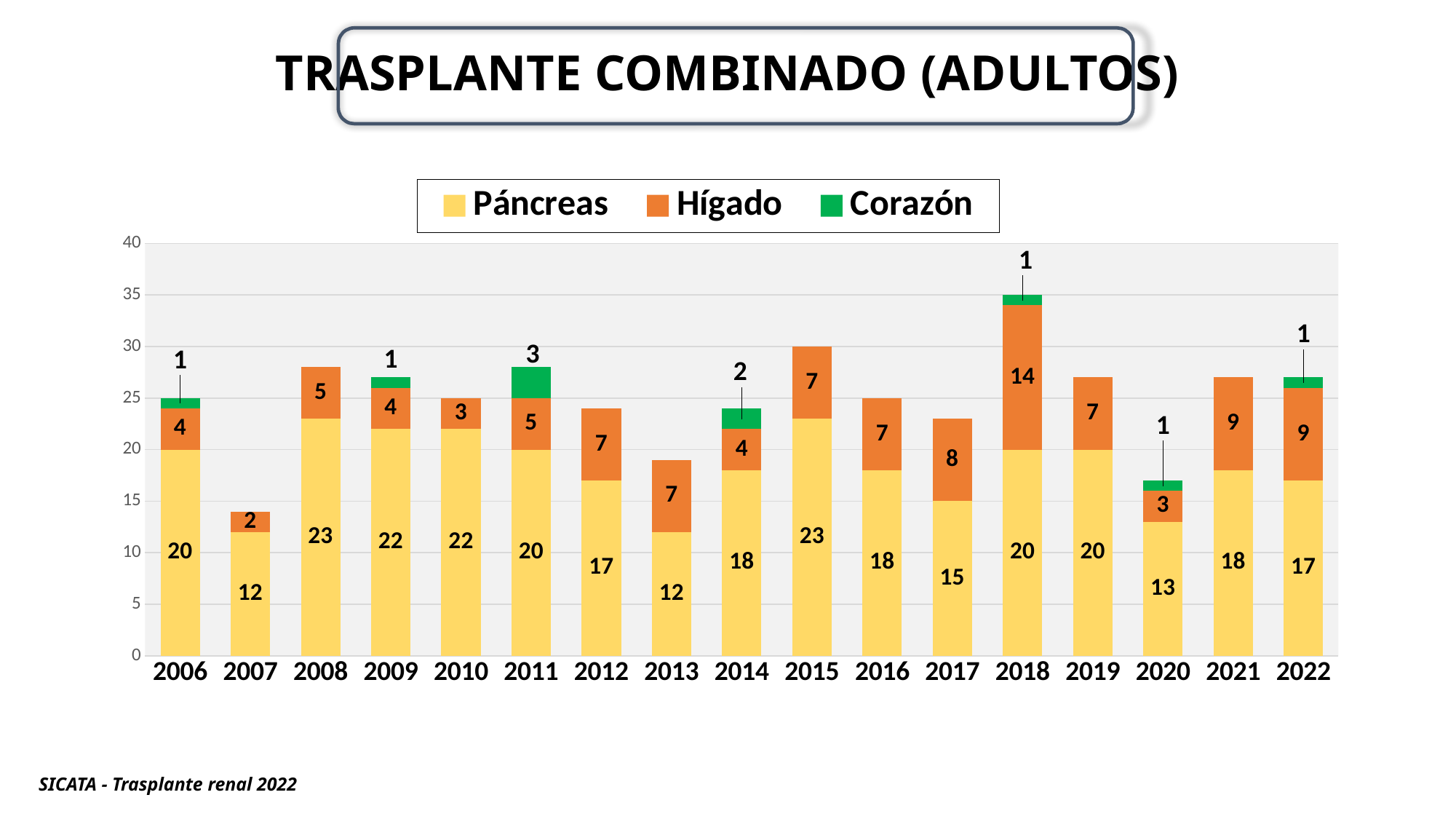
What type of chart is shown on the slide? Stacked bar chart How many series does the legend list? 3 What is the title of the chart? TRASPLANTE COMBINADO (ADULTOS) What is the difference between the Páncreas values for 2015 and 2013? 11 What is the Hígado value for 2018? 14 What is the total of the stacked bar for 2018? 35 How many years are shown on the x axis? 17 What is the Páncreas value for 2008? 23 Which year has the lowest Hígado value? 2007 Which is larger, the Hígado value for 2021 or the Hígado value for 2019? 2021 Which year has the highest Hígado value? 2018 What is the Corazón value for 2011? 3